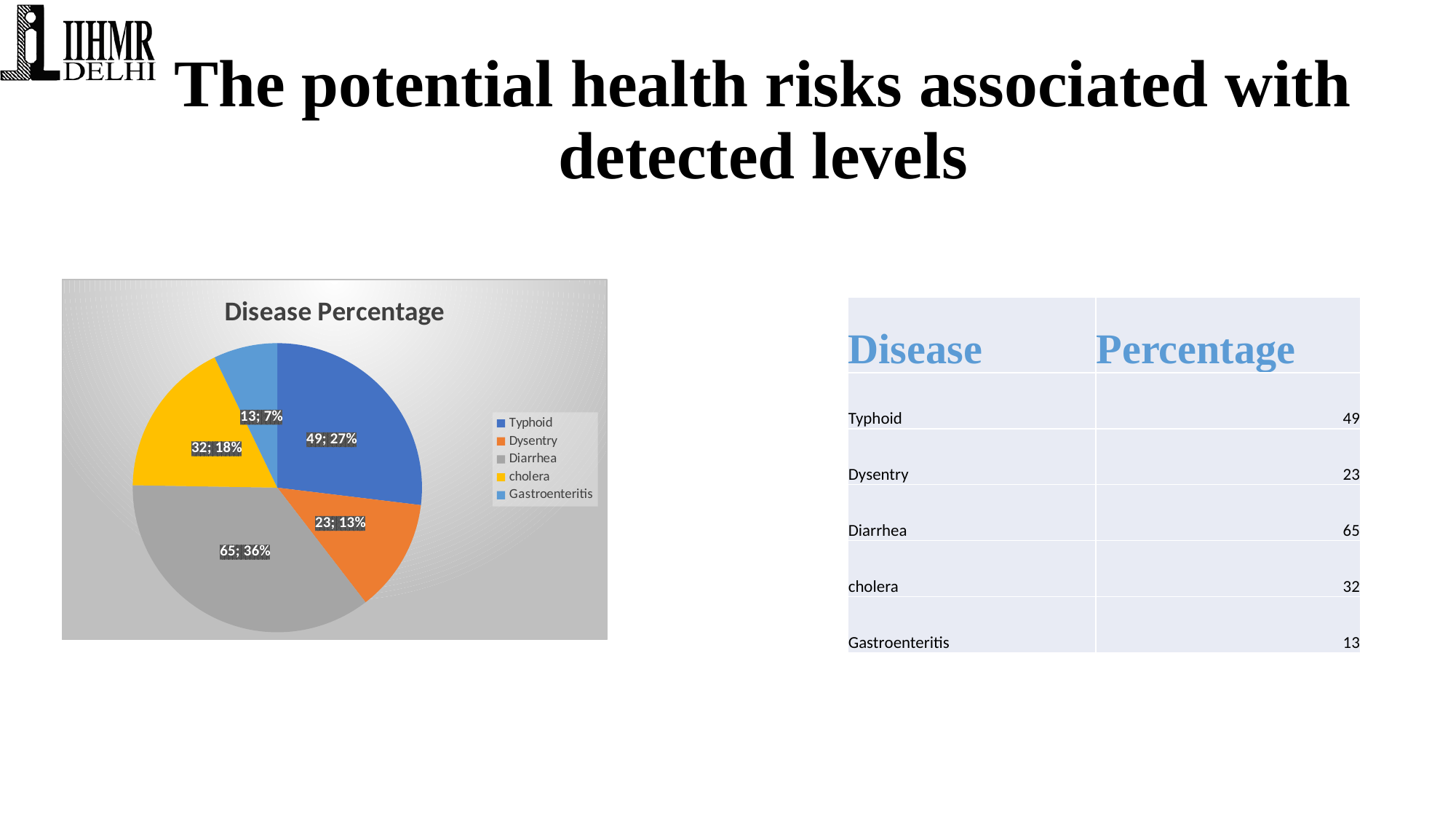
What percentage share of the pie does Dysentry have? 13% How many slices does the pie chart have? 5 Which disease has the smallest slice of the pie? Gastroenteritis What percentage share of the pie does cholera have? 18% What is the difference between the values for Diarrhea and Typhoid? 16 Which is larger, the value for cholera or the value for Dysentry? cholera Which disease has the largest slice of the pie? Diarrhea What is the title of the chart? Disease Percentage What is the value shown for Typhoid in the pie chart? 49 What is the value shown for Gastroenteritis in the pie chart? 13 What is the value shown for Diarrhea in the pie chart? 65 What kind of chart is shown on the slide? pie chart